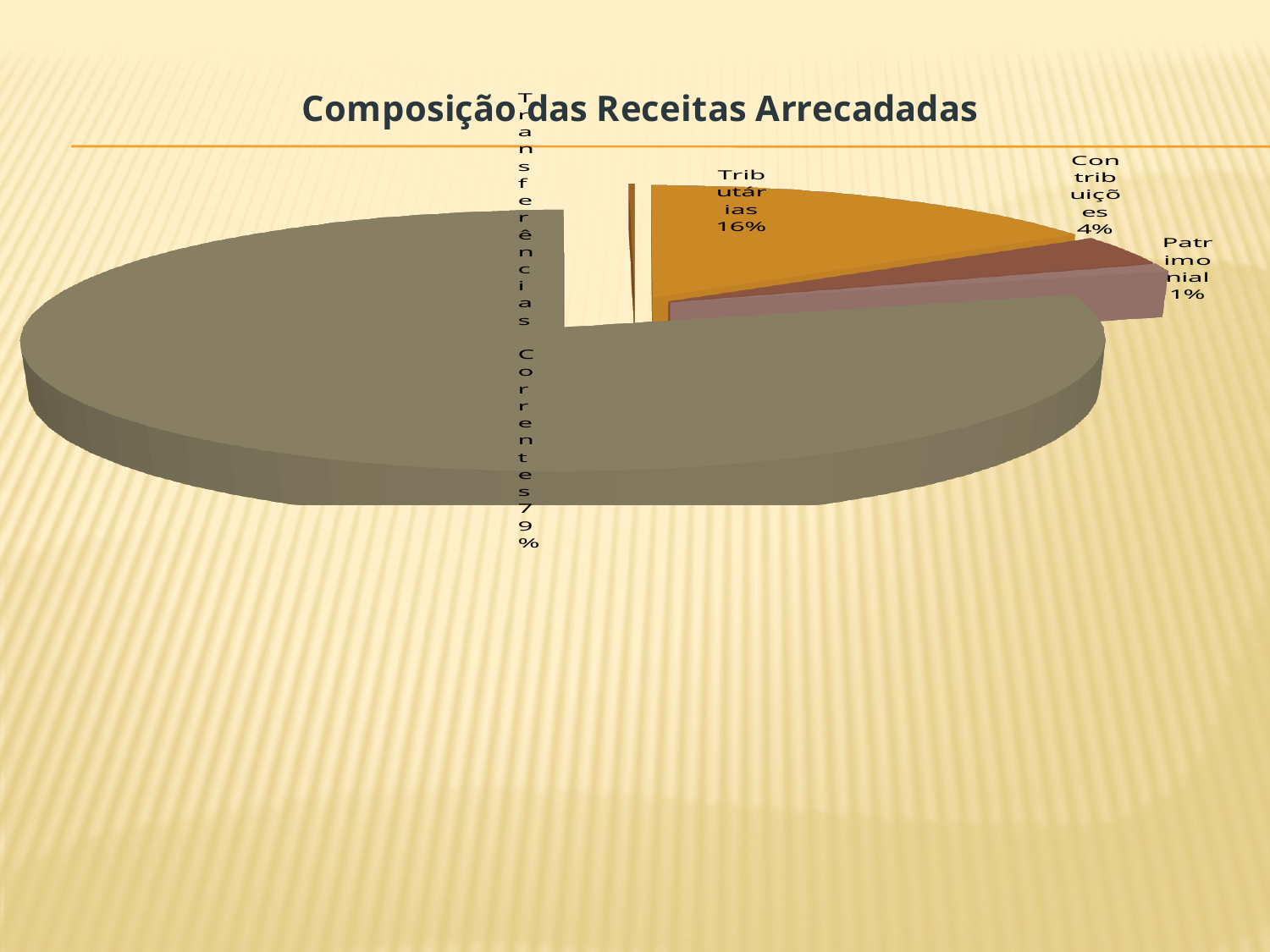
What percentage is shown for Tributárias? 16% Which is larger, the share for Tributárias or the share for Contribuições? Tributárias What share of the pie does Transferências Correntes represent? 79% What is the title of the chart? Composição das Receitas Arrecadadas Which category has the largest slice of the pie? Transferências Correntes Which labelled category has the smallest slice of the pie? Patrimonial What is the difference in percentage points between Contribuições and Patrimonial? 3 What percentage is shown for Patrimonial? 1% What is the difference in percentage points between Transferências Correntes and Tributárias? 63 What kind of chart is shown on the slide? pie chart What is the combined share of Tributárias and Contribuições? 20% What percentage is shown for Contribuições? 4%